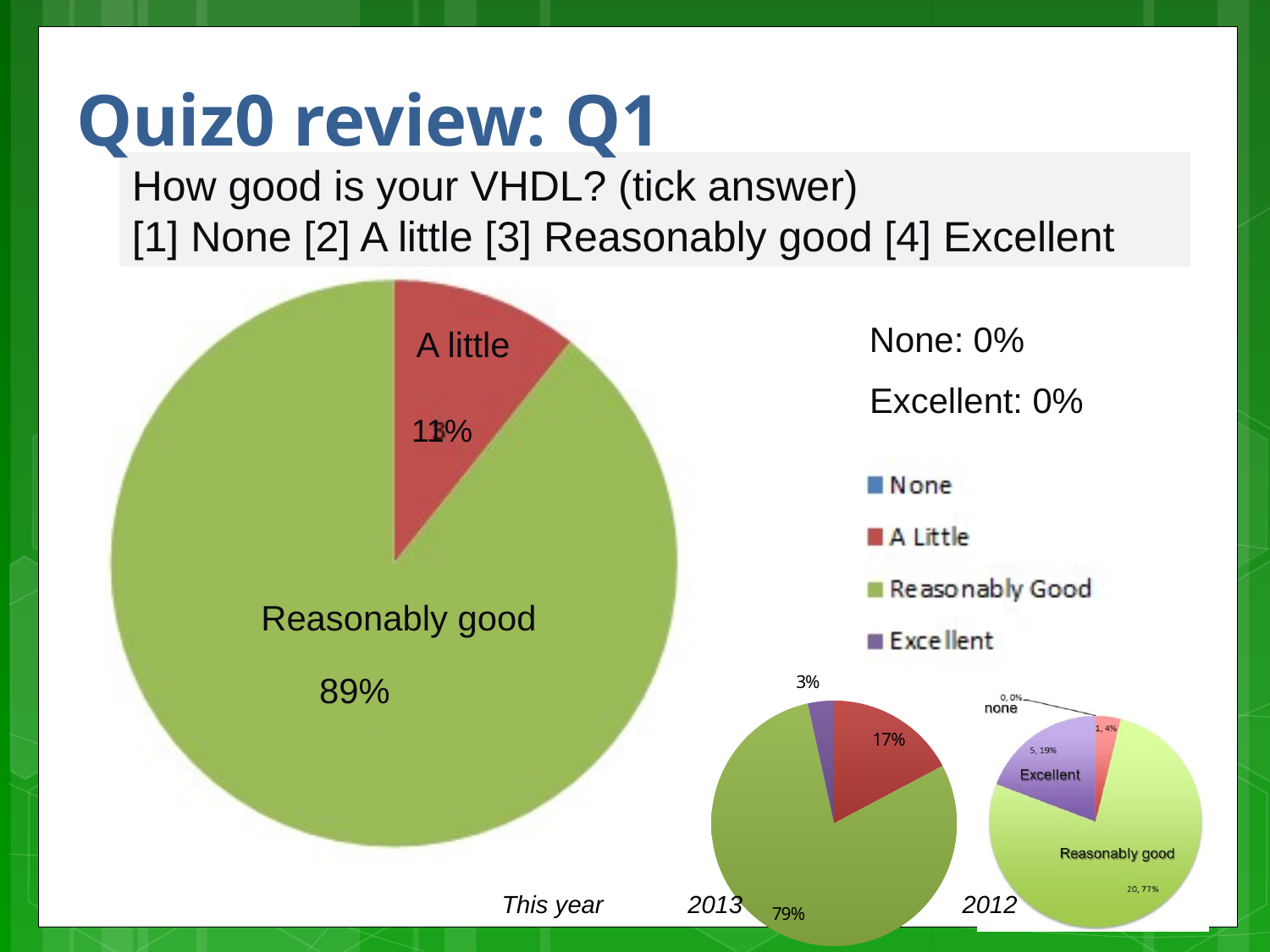
In the 2013 pie chart, which category has the smallest non-zero slice? Excellent How many entries does the legend list? 4 What kind of chart is used to show the 'This year' results? Pie chart In the 'This year' pie chart, what share is labelled for Reasonably good? 89% In the 'This year' pie chart, what percentage is given for Excellent? 0% In the 2013 pie chart, what share is labelled for the A little slice? 17% In the 2012 pie chart, what share is labelled for Excellent? 19% In the 'This year' pie chart, which category has the largest slice? Reasonably good Which has the larger Reasonably good share, the 'This year' pie chart or the 2013 pie chart? This year In the 'This year' pie chart, what percentage is given for None? 0%